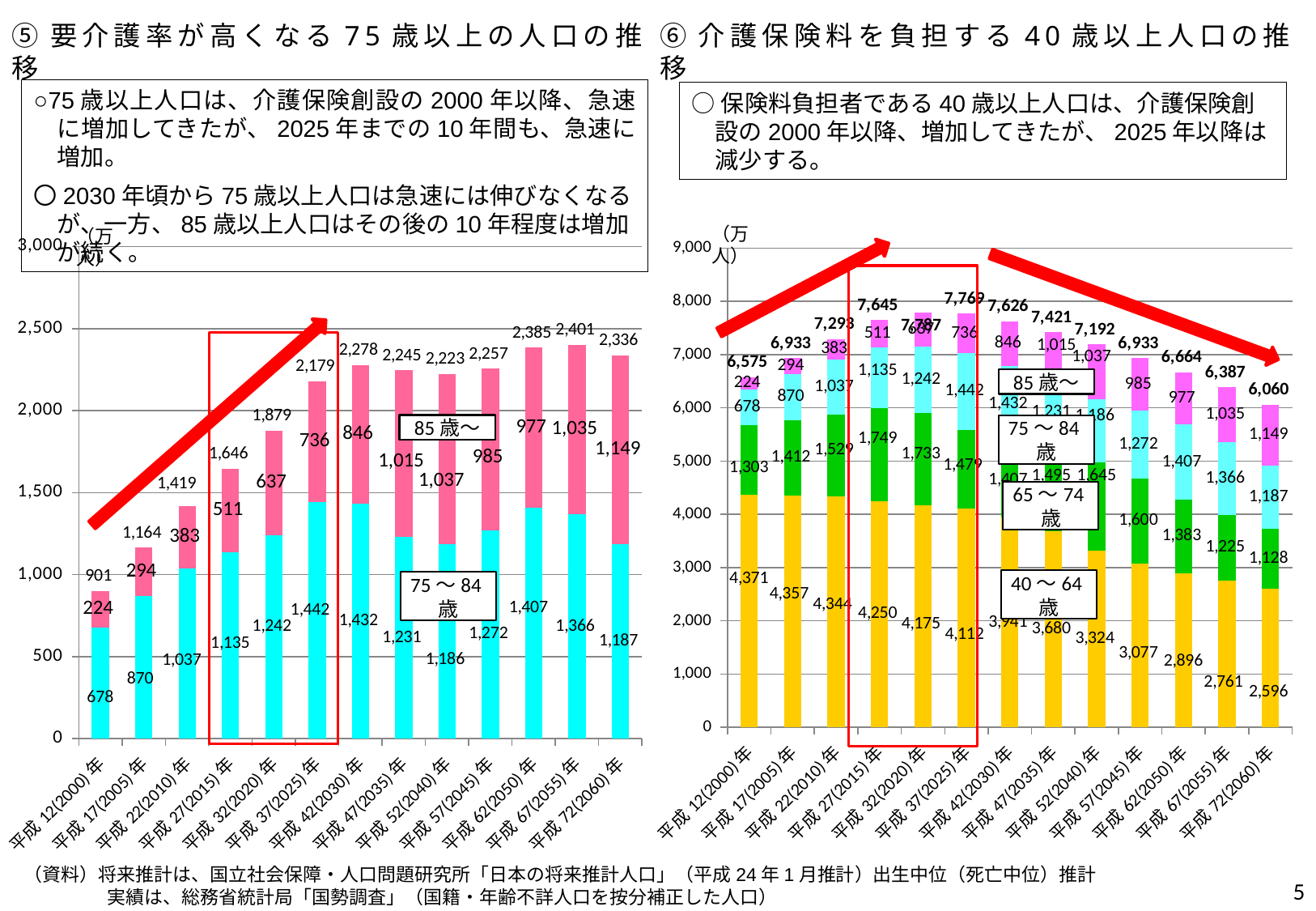
In the right chart (⑥ 40歳以上人口の推移), is the 40～64歳 value for 平成12(2000)年 larger or smaller than the 40～64歳 value for 平成52(2040)年? larger In the left chart (⑤ 75歳以上の人口の推移), which year has the highest total value? 平成67(2055)年 In the left chart (⑤ 75歳以上の人口の推移), what is the 85歳～ value for 平成12(2000)年? 224 In the left chart (⑤ 75歳以上の人口の推移), what is the difference between the 75～84歳 value and the 85歳～ value for 平成72(2060)年? 38 In the right chart (⑥ 40歳以上人口の推移), do the total values rise or fall from 平成37(2025)年 to 平成72(2060)年? fall In the left chart (⑤ 75歳以上の人口の推移), how many years (bars) are plotted? 13 What type of chart is the right chart (⑥ 40歳以上人口の推移)? stacked bar chart In the right chart (⑥ 40歳以上人口の推移), which year has the lowest total value? 平成72(2060)年 In the right chart (⑥ 40歳以上人口の推移), what is the total value labeled for 平成32(2020)年? 7,787 In the left chart (⑤ 75歳以上の人口の推移), what is the total population value labeled for 平成37(2025)年? 2,179 In the right chart (⑥ 40歳以上人口の推移), what is the 40～64歳 value for 平成72(2060)年? 2,596